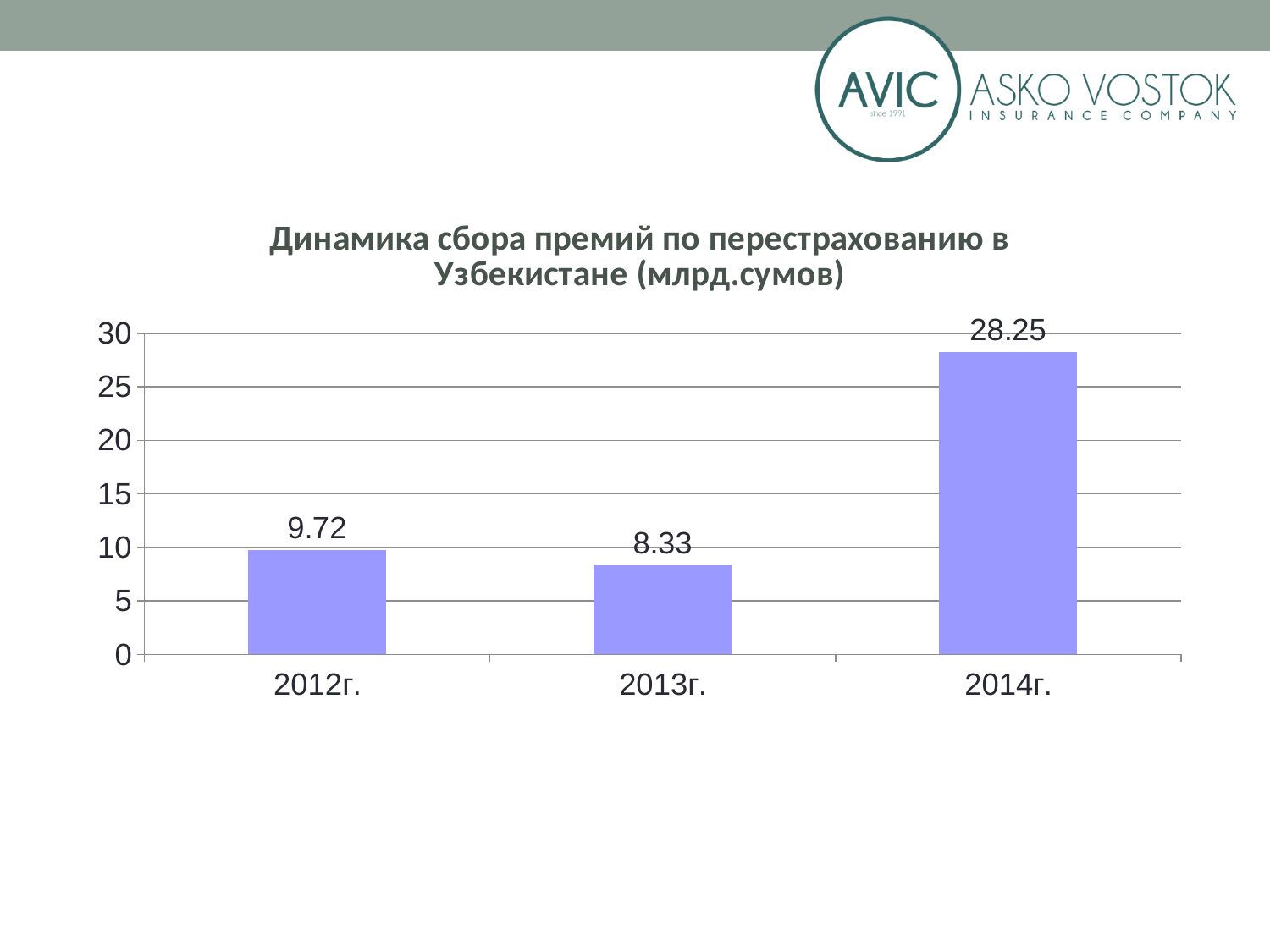
Which is larger, the value for 2012г. or the value for 2013г.? 2012г. Which year has the highest value? 2014г. What is the value for 2013г.? 8.33 What is the title of the chart? Динамика сбора премий по перестрахованию в Узбекистане (млрд.сумов) Is the value for 2014г. greater or less than 25? greater What is the difference between the values for 2014г. and 2012г.? 18.53 What kind of chart is shown on the slide? bar chart How many years are shown on the chart? 3 What is the value for 2012г.? 9.72 What is the value for 2014г.? 28.25 Which year has the lowest value? 2013г. What is the difference between the values for 2012г. and 2013г.? 1.39